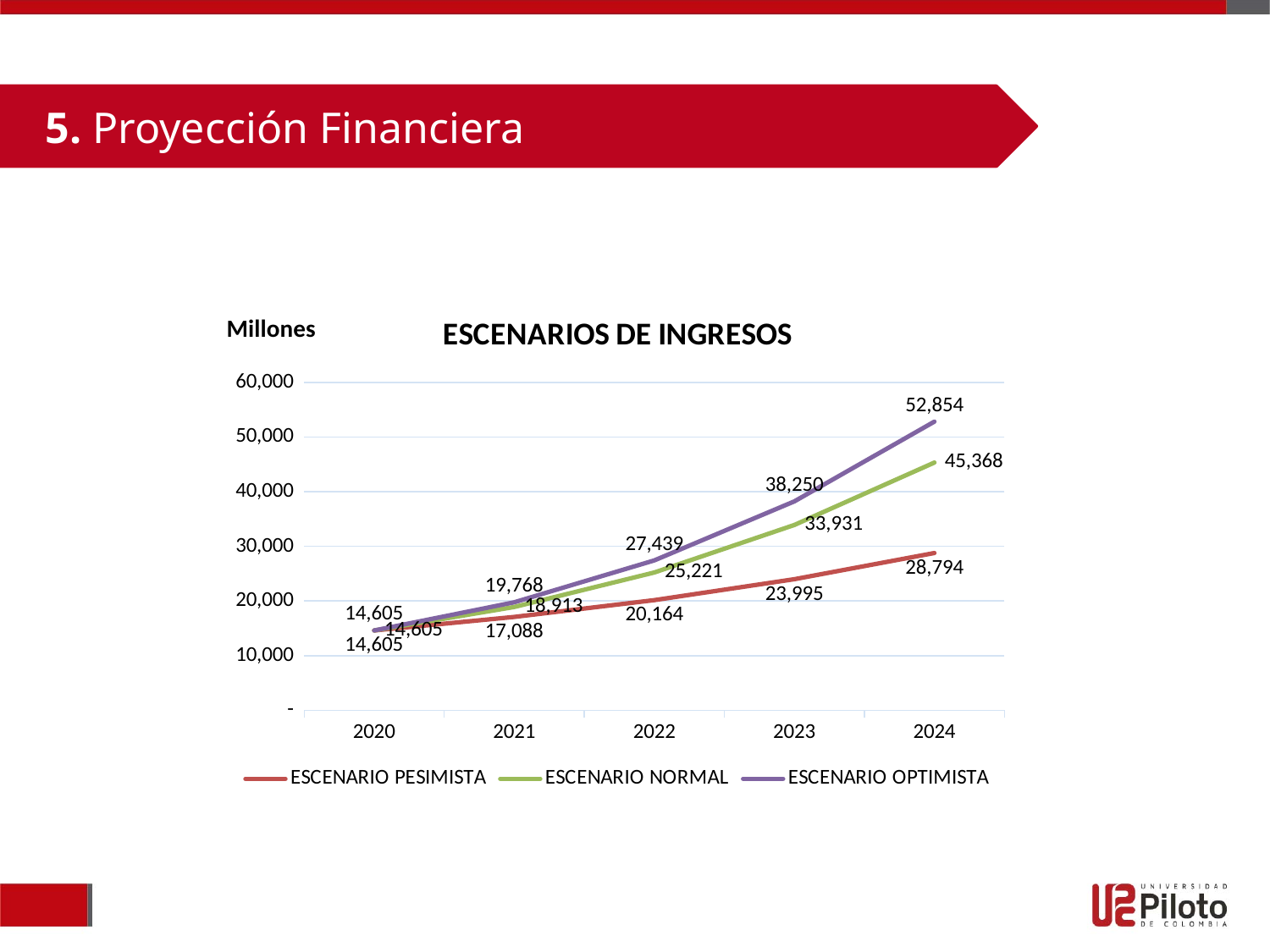
What is the difference between ESCENARIO OPTIMISTA and ESCENARIO PESIMISTA in 2024? 24,060 Is the value of ESCENARIO OPTIMISTA in 2024 greater or less than 50,000? greater How many years are shown on the x axis? 5 Do the values of ESCENARIO PESIMISTA rise or fall from 2020 to 2024? rise What is the value of ESCENARIO NORMAL in 2023? 33,931 What is the value of ESCENARIO PESIMISTA in 2022? 20,164 What is the value of ESCENARIO OPTIMISTA in 2024? 52,854 What kind of chart is shown on the slide? line chart What is the title of the chart? ESCENARIOS DE INGRESOS How many series does the legend list? 3 In which year does ESCENARIO NORMAL reach its highest value? 2024 Which is larger in 2023, ESCENARIO NORMAL or ESCENARIO PESIMISTA? ESCENARIO NORMAL